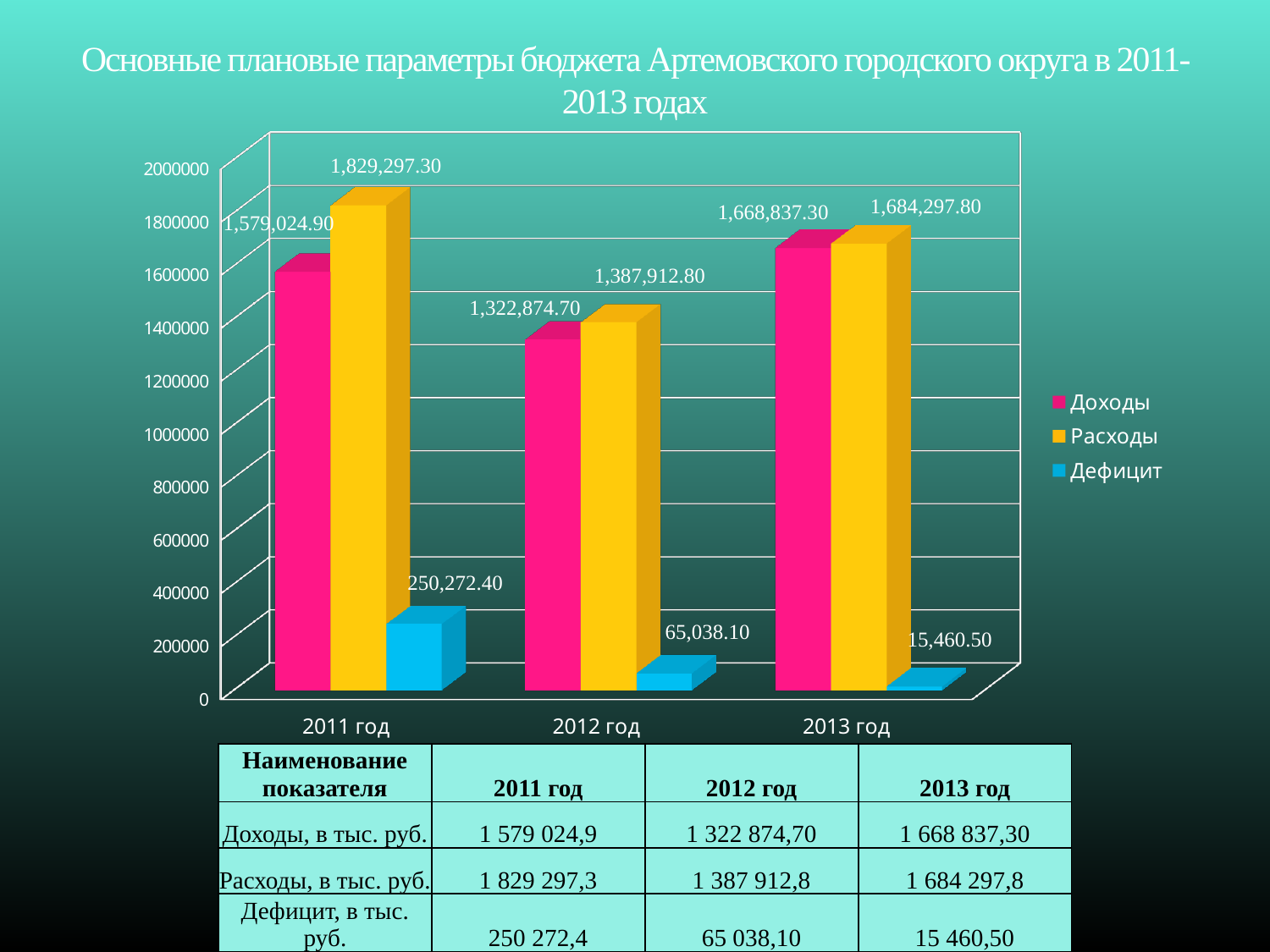
What is the value of Расходы for 2011 год? 1,829,297.30 In which year is Расходы the highest? 2011 год What is the value of Доходы for 2012 год? 1,322,874.70 What is the difference between Расходы and Доходы in 2012 год? 65,038.10 What is the value of Дефицит for 2013 год? 15,460.50 How many years are shown on the x axis? 3 What kind of chart is shown on the slide? bar chart Does the value of Дефицит rise or fall from 2011 год to 2013 год? fall In which year is Дефицит the lowest? 2013 год How many series does the legend list? 3 Which is larger in 2013 год, Доходы or Расходы? Расходы Is the value of Доходы for 2011 год greater or less than 1400000? greater